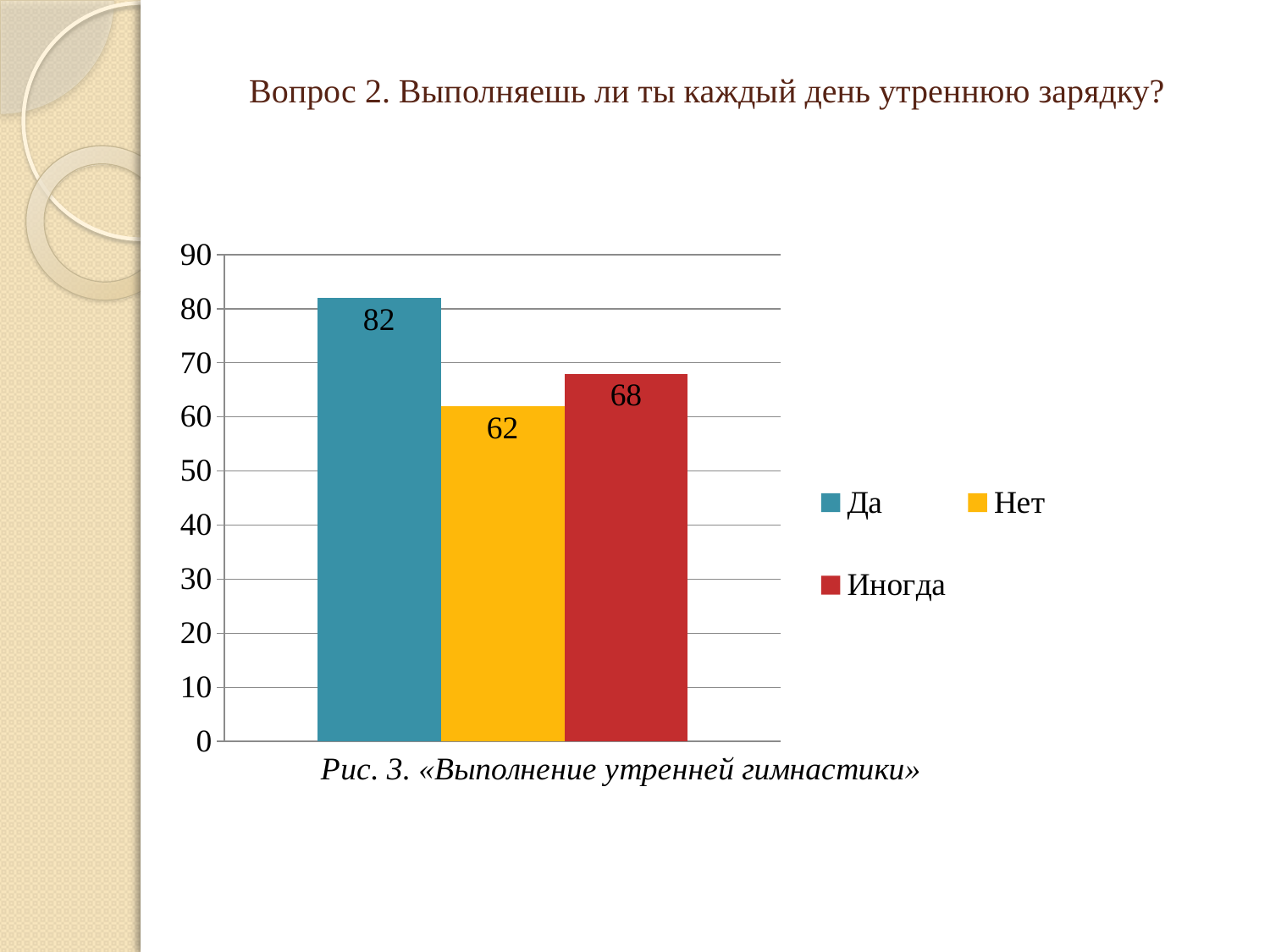
How many series does the legend list? 3 What is the value for Иногда? 68 What is the difference between the values for Да and Нет? 20 What is the difference between the values for Иногда and Нет? 6 Which category has the highest value? Да Is the value for Да greater or less than 70? greater What is the caption below the chart? Рис. 3. «Выполнение утренней гимнастики» Which is larger, the value for Иногда or the value for Нет? Иногда Which category has the lowest value? Нет What is the value for Да? 82 What is the value for Нет? 62 What kind of chart is shown on the slide? bar chart